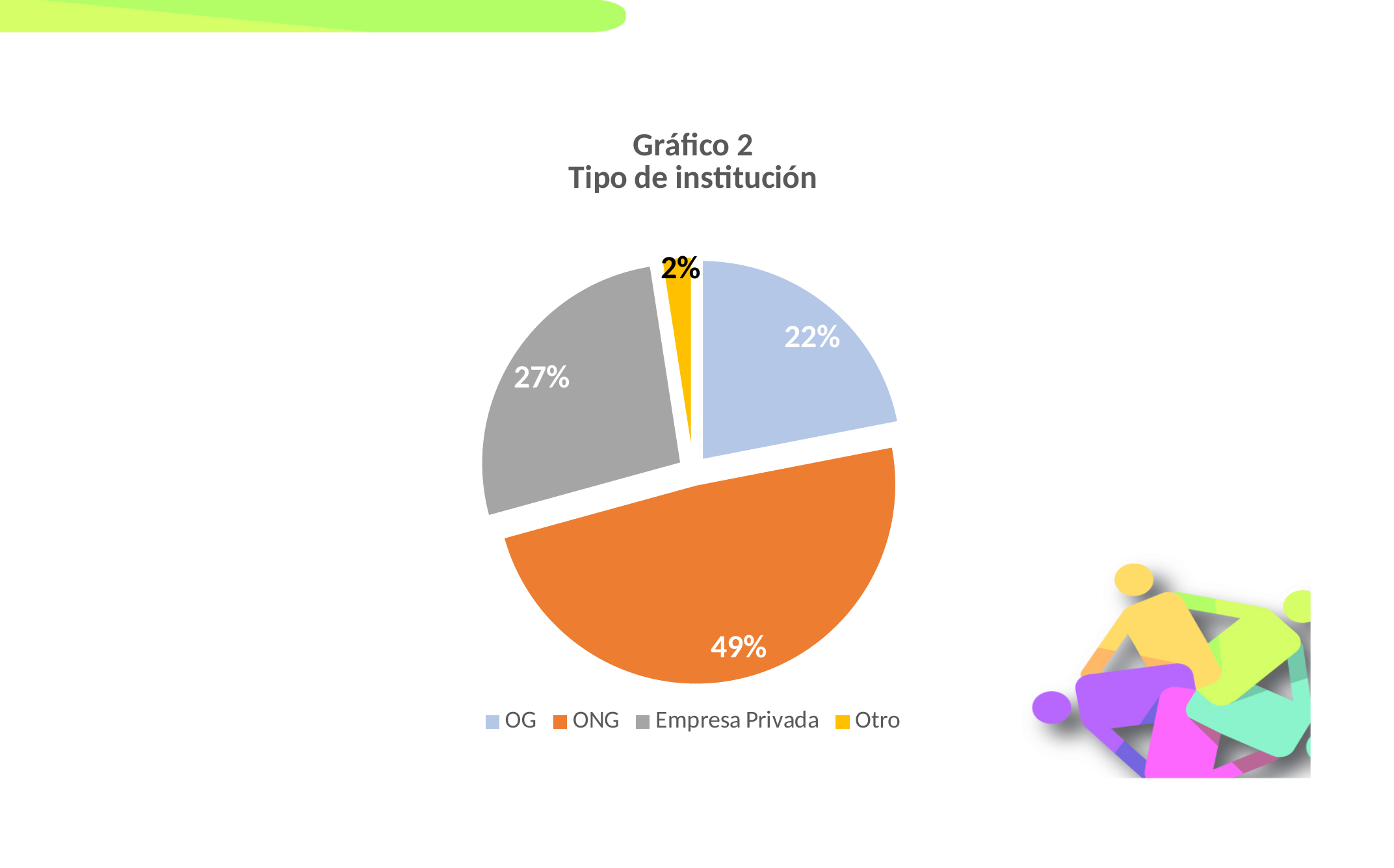
Which category has the largest share of the pie? ONG How many categories does the pie chart have? 4 What percentage of the pie does Otro represent? 2% What percentage of the pie does OG represent? 22% What type of chart is shown on the slide? pie chart What is the title of the chart? Gráfico 2 Tipo de institución What colour is the ONG slice? orange What percentage of the pie does Empresa Privada represent? 27% Which is larger, the share for OG or the share for Empresa Privada? Empresa Privada What percentage of the pie does ONG represent? 49% What is the difference in percentage points between ONG and Empresa Privada? 22 Which category has the smallest share of the pie? Otro